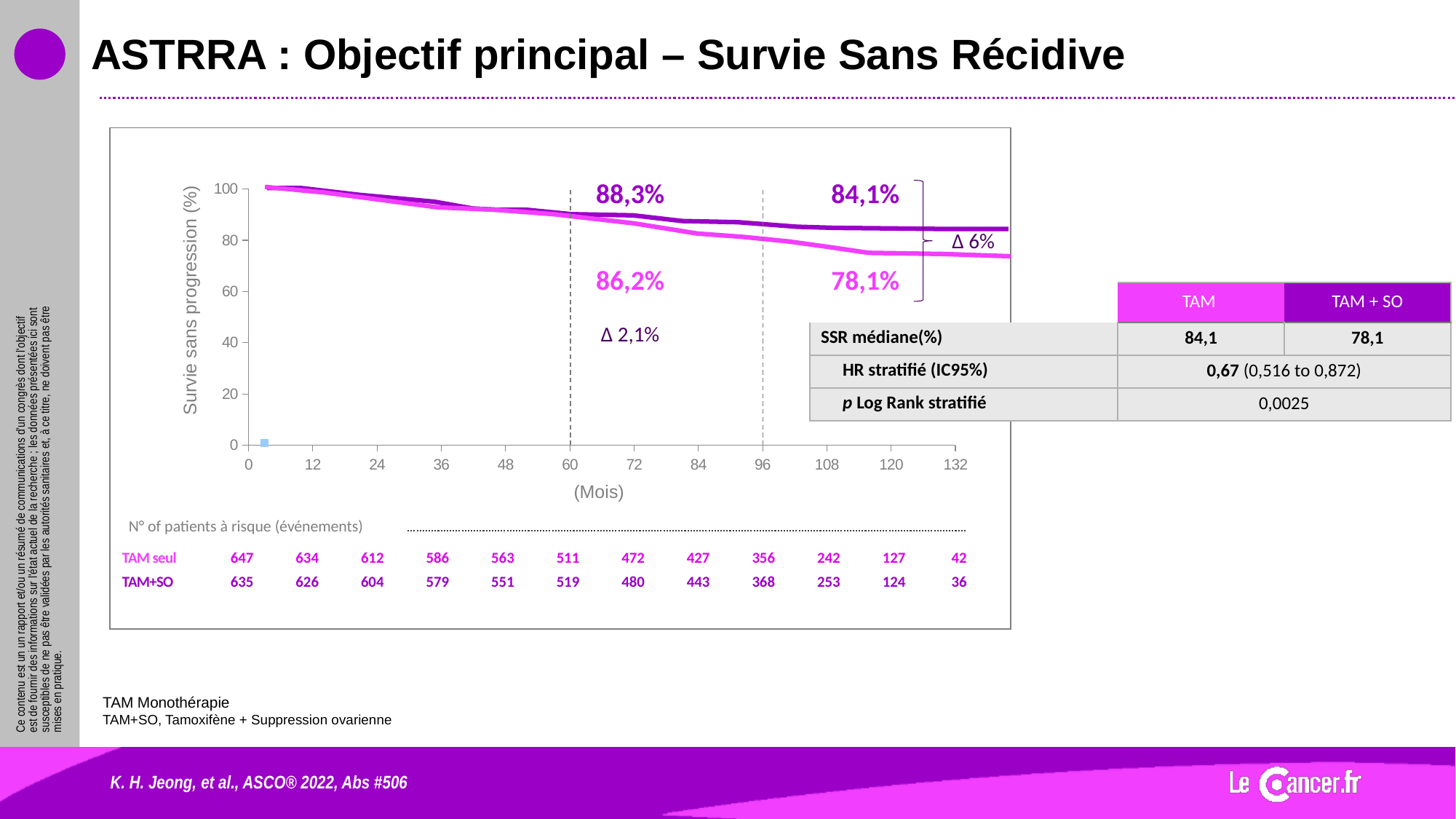
What is the difference between the two curves at 96 months, as printed on the chart? Δ 6% What is the value printed for the lower curve at 60 months? 86,2% What is the difference between the two curves at 60 months, as printed on the chart? Δ 2,1% How many patients at risk are listed for TAM+SO at 132 months? 36 How many patients at risk are listed for TAM seul at 0 months? 647 What is the value printed for the upper curve at 60 months? 88,3% Do the survival curves rise or fall as the months increase? fall How many survival curves are plotted on the chart? 2 What is the value printed for the upper curve at 96 months? 84,1% What kind of chart is shown on the slide? line chart Is the value of the lower curve at 132 months greater or less than 80? less What is the value printed for the lower curve at 96 months? 78,1%